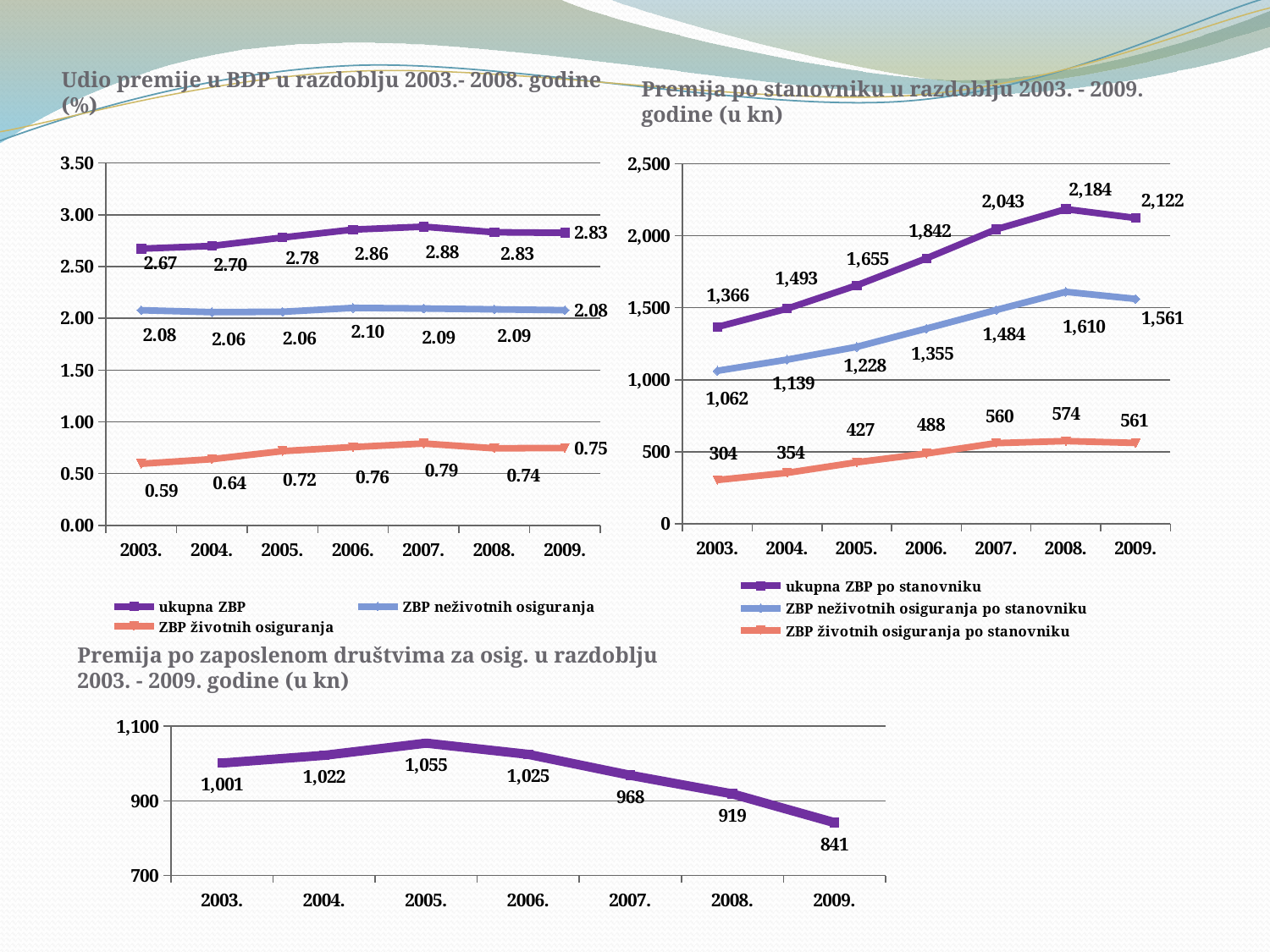
In the chart 'Udio premije u BDP u razdoblju 2003.- 2008. godine (%)', how many series does the legend list? 3 In the chart 'Premija po zaposlenom društvima za osig. u razdoblju 2003. - 2009. godine (u kn)', do the values rise or fall from 2005. to 2009.? Fall In the chart 'Udio premije u BDP u razdoblju 2003.- 2008. godine (%)', in which year is ZBP životnih osiguranja lowest? 2003. In the chart 'Premija po stanovniku u razdoblju 2003. - 2009. godine (u kn)', what is the value of ukupna ZBP po stanovniku in 2008.? 2,184 What kind of chart is 'Premija po zaposlenom društvima za osig. u razdoblju 2003. - 2009. godine (u kn)'? Line chart In the chart 'Udio premije u BDP u razdoblju 2003.- 2008. godine (%)', what is the difference between ukupna ZBP in 2007. and in 2003.? 0.21 In the chart 'Premija po stanovniku u razdoblju 2003. - 2009. godine (u kn)', what is the difference between ZBP neživotnih osiguranja po stanovniku in 2008. and in 2009.? 49 In the chart 'Udio premije u BDP u razdoblju 2003.- 2008. godine (%)', what is the value of ukupna ZBP in 2007.? 2.88 In the chart 'Premija po zaposlenom društvima za osig. u razdoblju 2003. - 2009. godine (u kn)', what is the value for 2009.? 841 In the chart 'Premija po stanovniku u razdoblju 2003. - 2009. godine (u kn)', which is larger: ZBP neživotnih osiguranja po stanovniku in 2003. or ZBP životnih osiguranja po stanovniku in 2009.? ZBP neživotnih osiguranja po stanovniku in 2003. In the chart 'Premija po stanovniku u razdoblju 2003. - 2009. godine (u kn)', how many years are shown on the x axis? 7 In the chart 'Premija po stanovniku u razdoblju 2003. - 2009. godine (u kn)', in which year is ZBP životnih osiguranja po stanovniku highest? 2008.